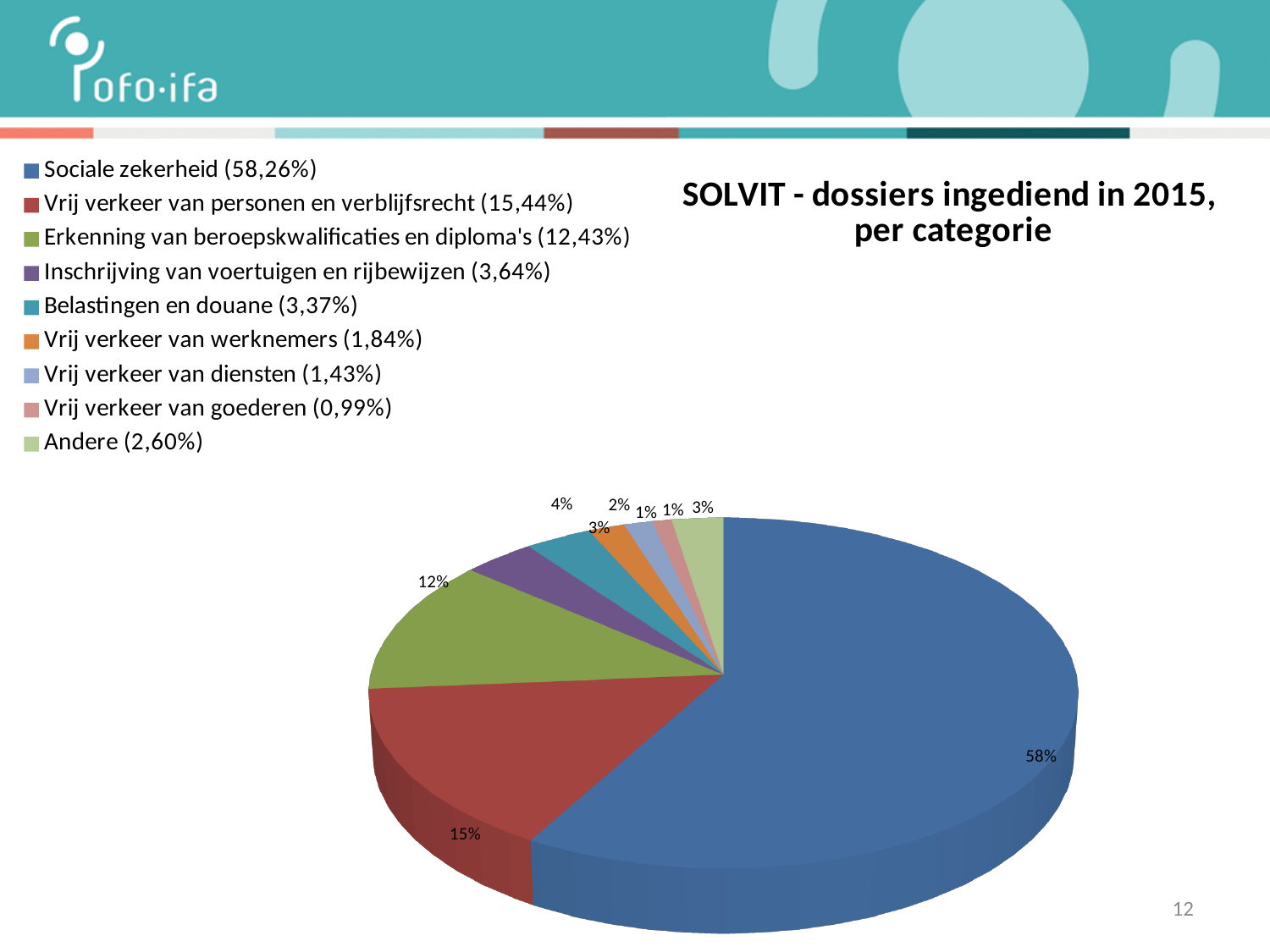
How many categories does the legend list? 9 Which category has the smallest share of the pie? Vrij verkeer van goederen Which has the larger share: Inschrijving van voertuigen en rijbewijzen or Belastingen en douane? Inschrijving van voertuigen en rijbewijzen Which category has the largest share of the pie? Sociale zekerheid What rounded data label is printed on the pie slice for Vrij verkeer van personen en verblijfsrecht? 15% What is the title of the chart? SOLVIT - dossiers ingediend in 2015, per categorie What percentage is shown in the legend for Belastingen en douane? 3,37% What is the difference in percentage points between Sociale zekerheid (58,26%) and Vrij verkeer van personen en verblijfsrecht (15,44%)? 42,82% What kind of chart is shown on the slide? pie chart What percentage is shown in the legend for Andere? 2,60% What percentage is shown in the legend for Erkenning van beroepskwalificaties en diploma's? 12,43% What percentage is shown in the legend for Sociale zekerheid? 58,26%